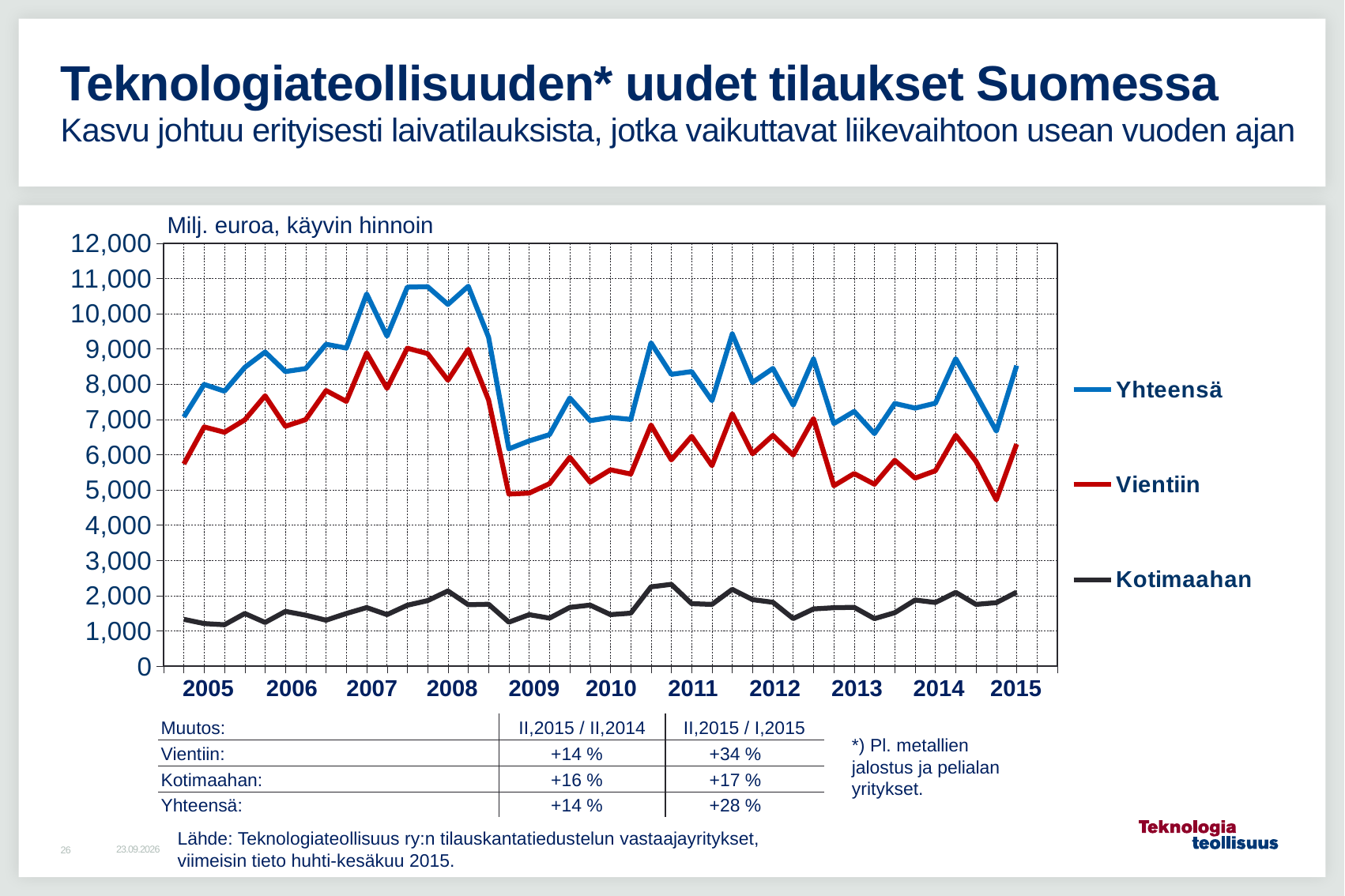
Which series are listed in the legend? Yhteensä, Vientiin, Kotimaahan How many years are labelled on the x axis? 11 What unit is stated above the chart? Milj. euroa, käyvin hinnoin Does the Yhteensä series rise or fall between 2008 and 2009? fall Which series has the lowest values throughout the chart? Kotimaahan Which is larger in 2015, Vientiin or Kotimaahan? Vientiin Is the value for Kotimaahan at any point greater or less than 3,000? less What kind of chart is shown on the slide? line chart Which series has the highest values throughout the chart? Yhteensä Is the value for Yhteensä at the start of 2009 greater or less than 7,000? less How many series does the legend list? 3 Is the value for Yhteensä at its 2008 peak greater or less than 10,000? greater